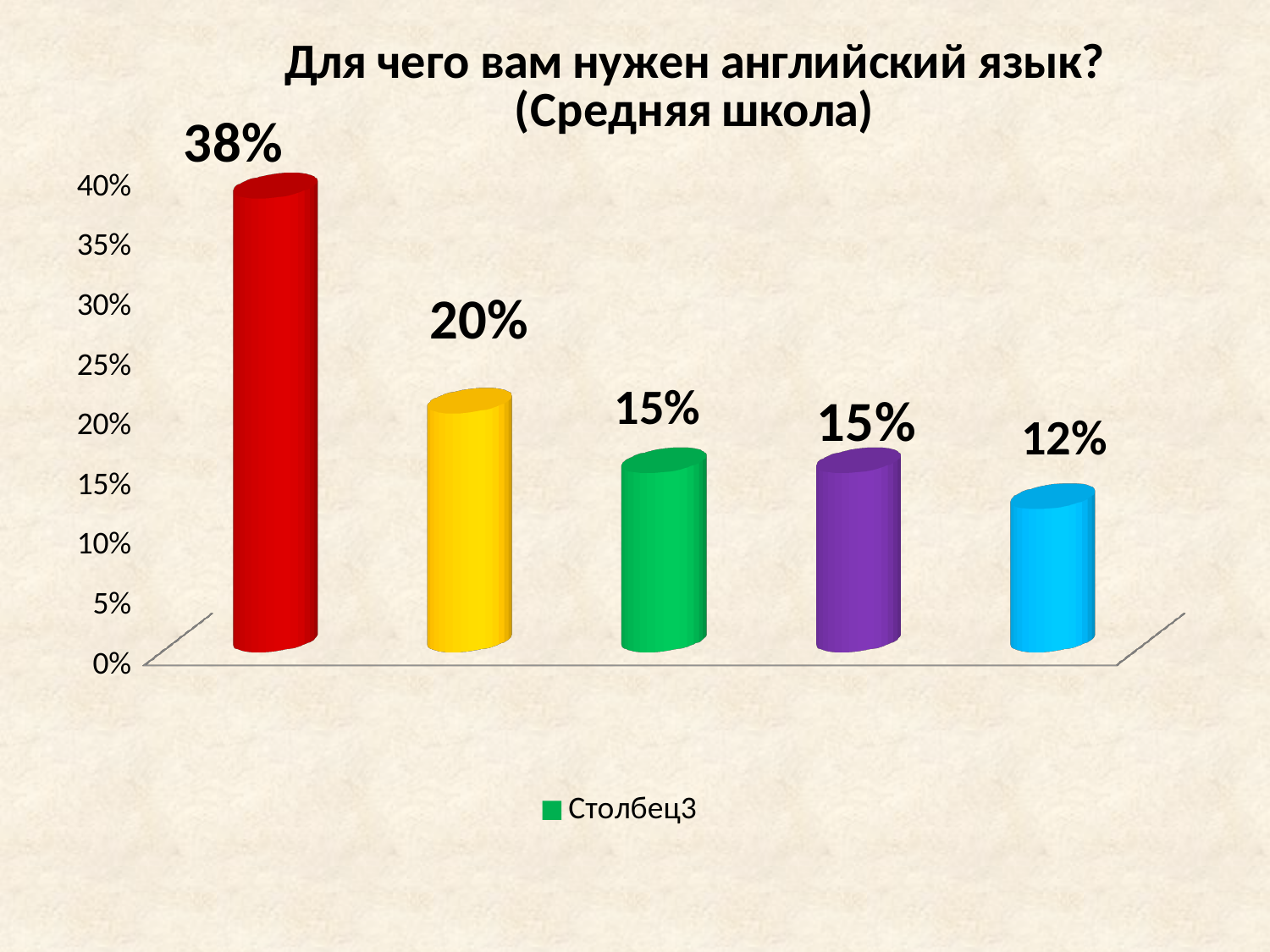
What is the title of the chart? Для чего вам нужен английский язык? (Средняя школа) How many bars are plotted in the chart? 5 What is the value shown on the red bar? 38% What is the difference between the red bar's value and the yellow bar's value? 18% What is the value shown on the light blue bar (rightmost)? 12% Which is larger, the value of the purple bar or the value of the light blue bar? The purple bar (15%) How many series does the legend list? 1 Which bar has the highest value? The red bar (38%) Which bar has the lowest value? The light blue bar (12%) What kind of chart is shown on the slide? Bar chart What is the value shown on the green bar? 15% What is the value shown on the yellow bar? 20%